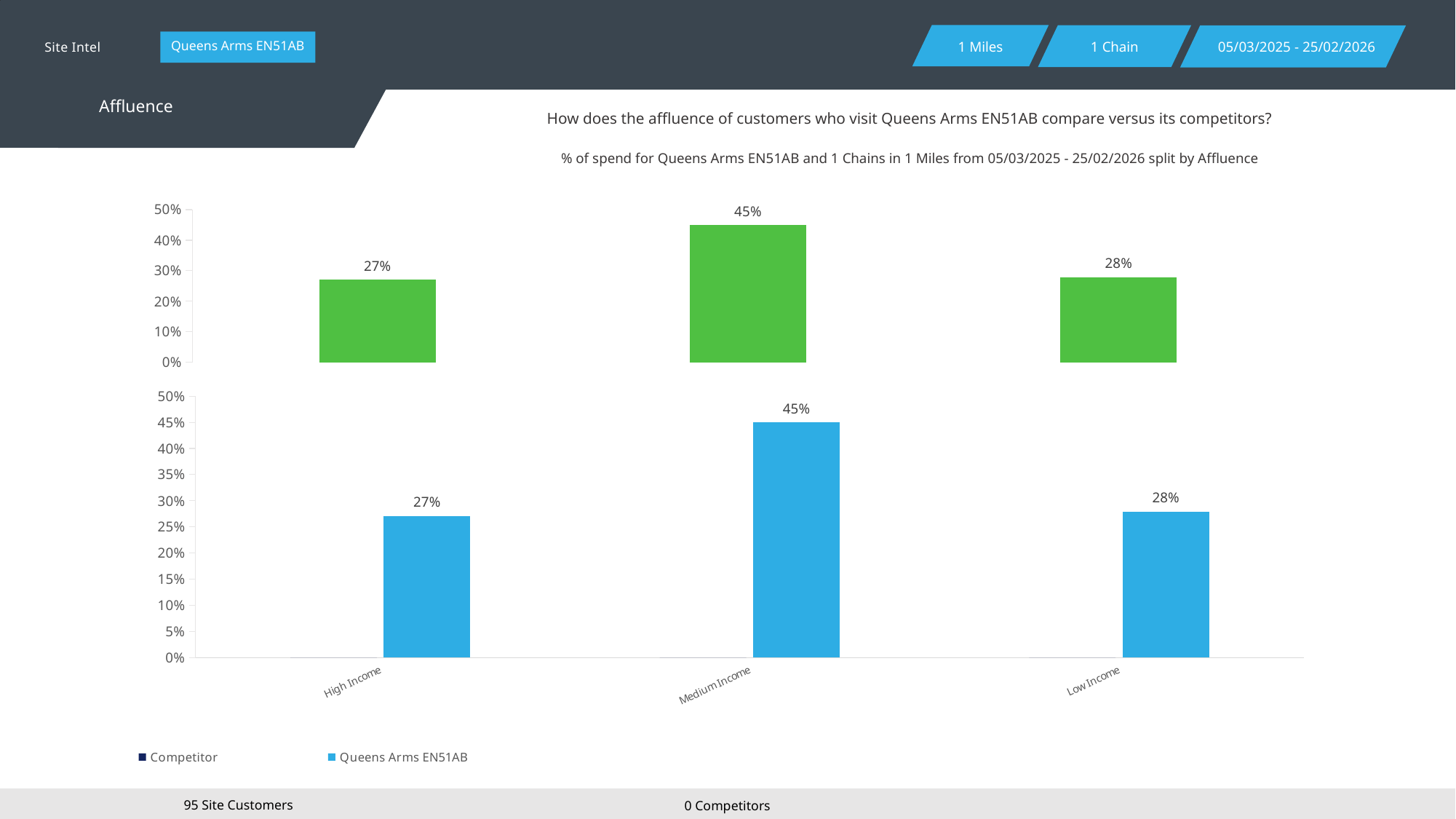
How many series does the legend list? 2 In the bottom chart, what is the difference between the values for Medium Income and High Income? 18% In the bottom chart, what is the value for High Income? 27% What type of chart is the bottom chart? Bar chart In the bottom chart, what is the value for Low Income? 28% In the top chart, what is the value of the middle bar? 45% How many categories are shown on the x axis of the bottom chart? 3 In the top chart, what is the difference between the highest bar and the lowest bar? 18% In the bottom chart, is the value for Medium Income greater or less than 40%? greater In the bottom chart, what is the value for Medium Income? 45% In the bottom chart, which category has the highest value? Medium Income In the bottom chart, which category has the lowest value? High Income